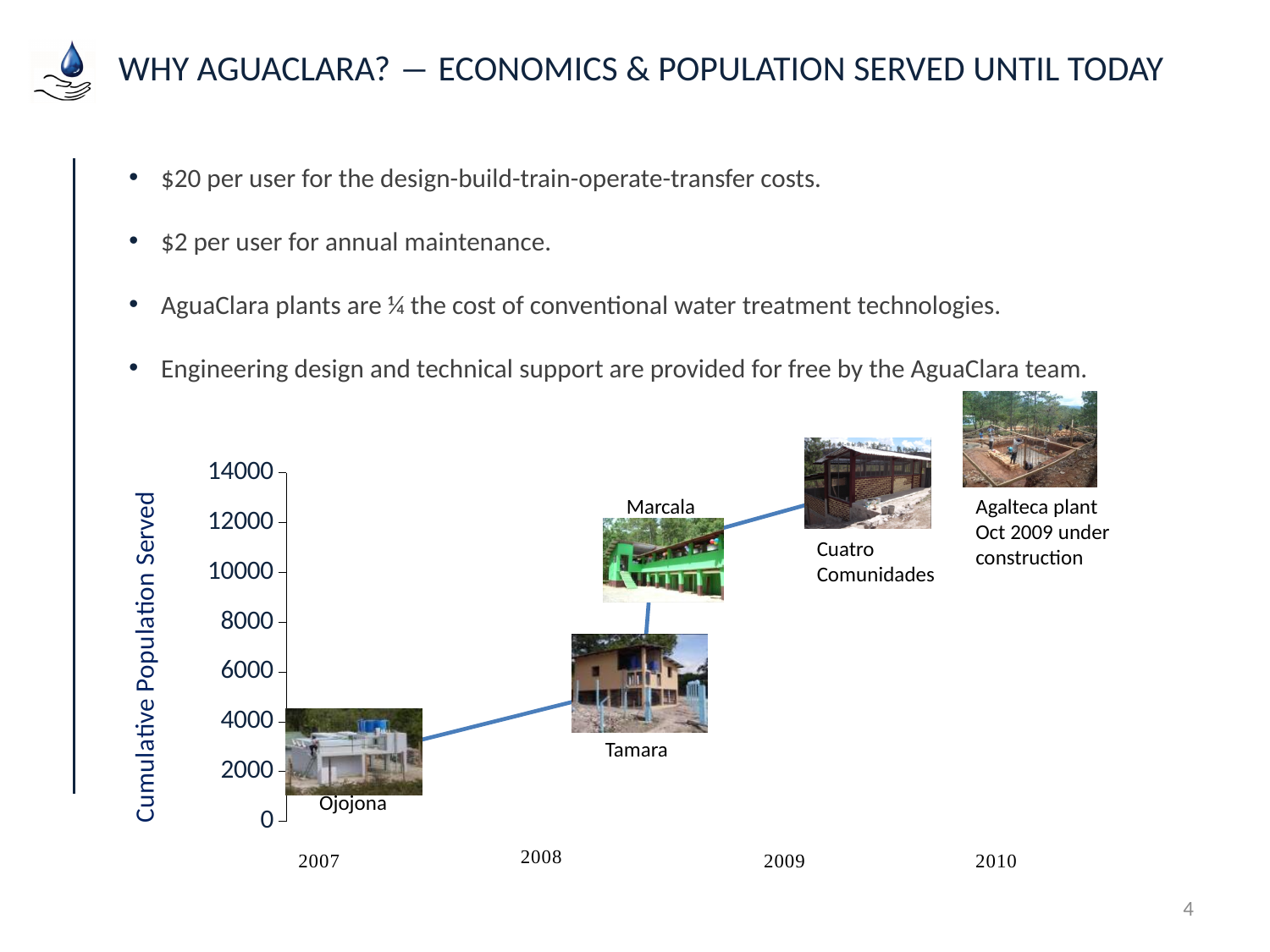
Is the cumulative population served at the Tamara point greater or less than 8000? less Which point shows a higher cumulative population served, Ojojona or Cuatro Comunidades? Cuatro Comunidades What is the label of the vertical axis of the chart? Cumulative Population Served Does the cumulative population served rise or fall from 2007 to 2009 in the chart? rise Is the cumulative population served at the Ojojona point (2007) greater or less than 4000? less Is the cumulative population served at the Cuatro Comunidades point greater or less than 10000? greater Which plant is labelled as the earliest (2007) point on the chart? Ojojona How many years are labelled along the x axis of the chart? 4 What kind of chart is shown on the slide? line chart Which point shows a higher cumulative population served, Ojojona or Tamara? Tamara What is the highest value shown on the y axis of the chart? 14000